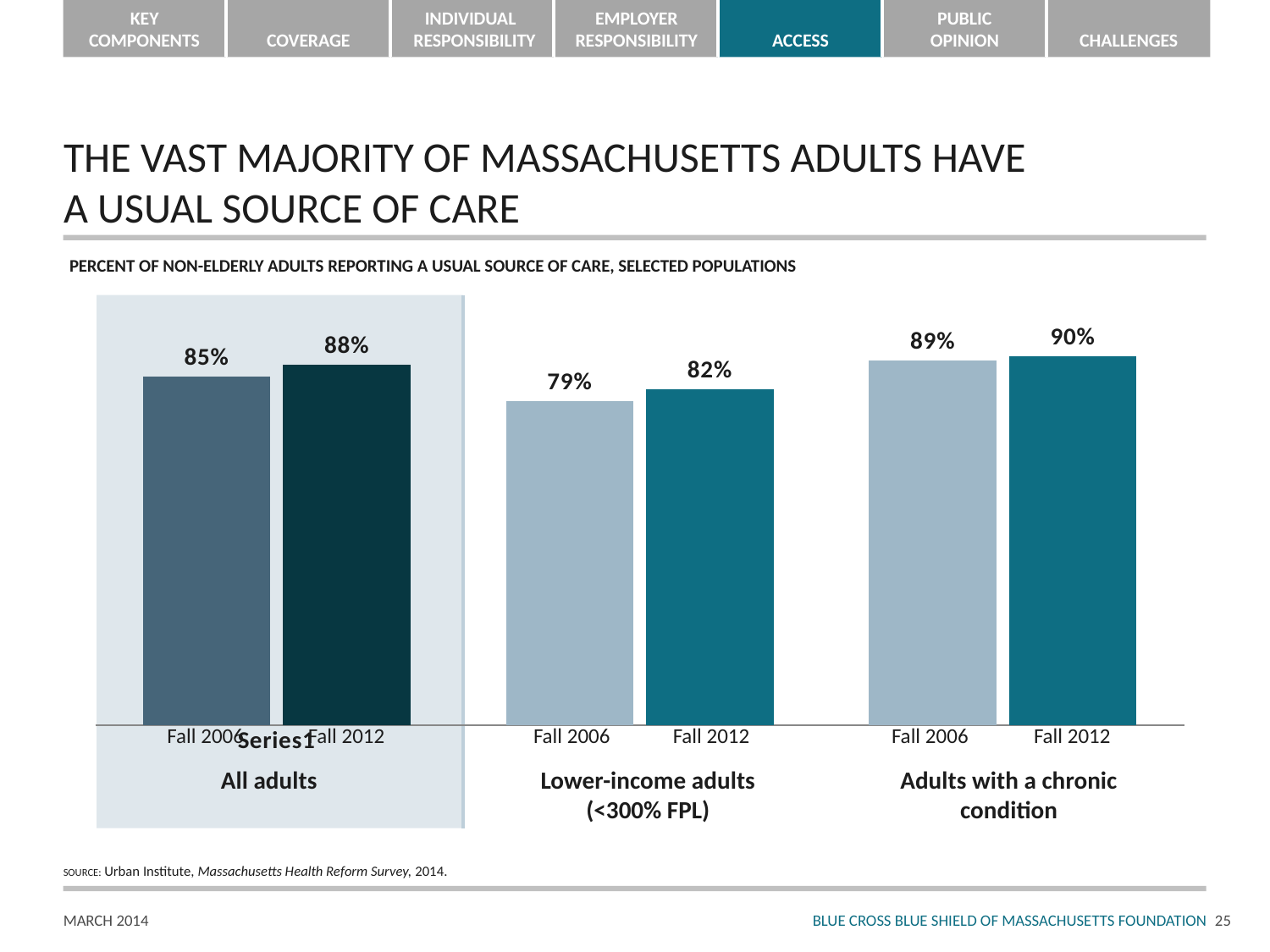
What percent of adults with a chronic condition reported a usual source of care in Fall 2006? 89% How many population groups are shown on the chart? 3 What is the title of the chart? Percent of non-elderly adults reporting a usual source of care, selected populations What type of chart is shown on the slide? Bar chart Which bar shows the highest value on the chart? Adults with a chronic condition, Fall 2012 (90%) Which is larger: the Fall 2012 value for all adults or the Fall 2006 value for adults with a chronic condition? Fall 2006 value for adults with a chronic condition What is the difference between the Fall 2012 and Fall 2006 values for lower-income adults? 3 percentage points Did the percent reporting a usual source of care rise or fall from Fall 2006 to Fall 2012 for adults with a chronic condition? Rise What percent of all adults reported a usual source of care in Fall 2006? 85% Which bar shows the lowest value on the chart? Lower-income adults, Fall 2006 (79%) By how many percentage points did the value for all adults change from Fall 2006 to Fall 2012? 3 percentage points What is the value for lower-income adults (<300% FPL) in Fall 2012? 82%